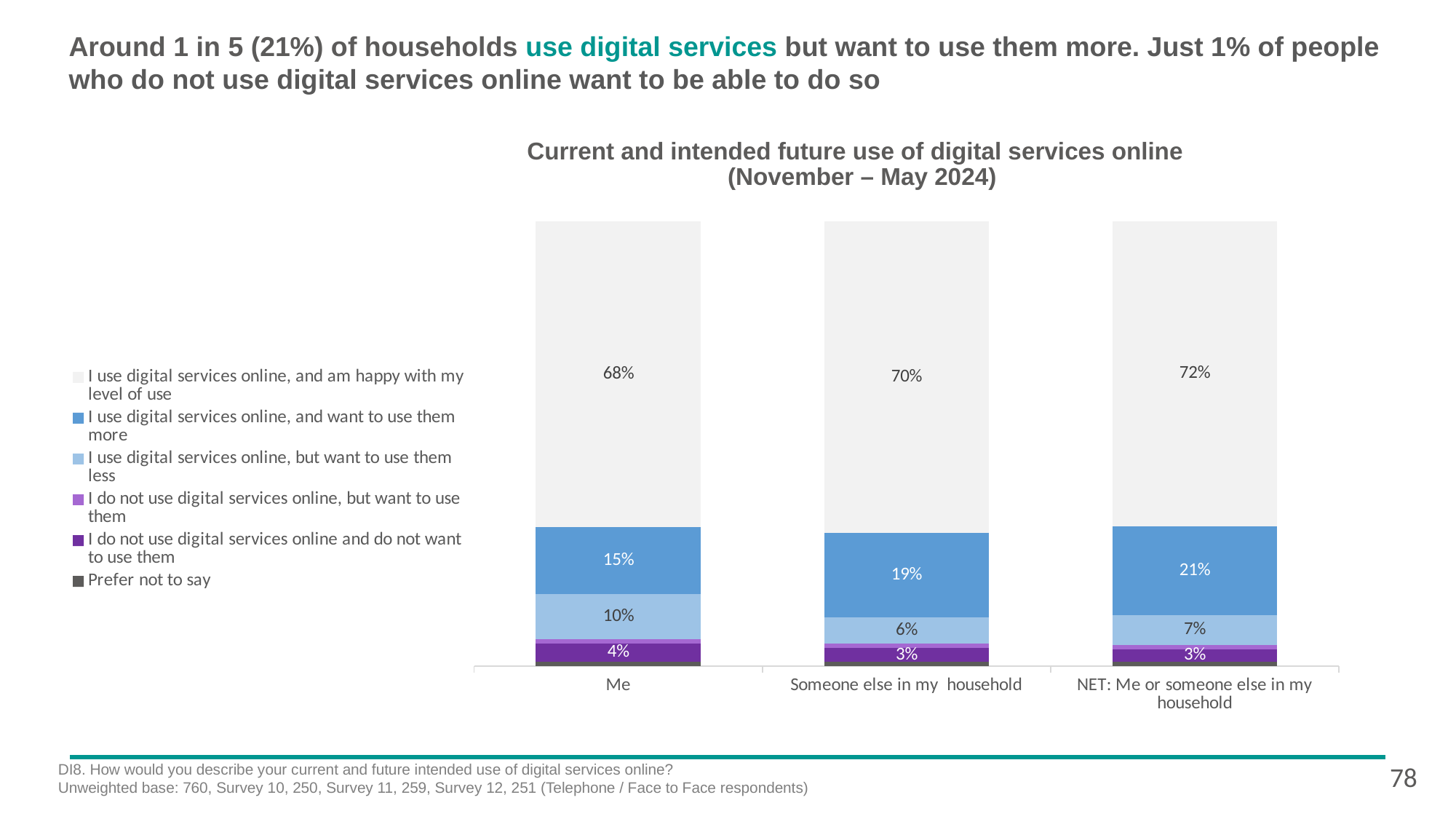
What is the value for 'I do not use digital services online and do not want to use them' in the 'Me' bar? 4% Which category has the highest value for 'I use digital services online, and am happy with my level of use'? NET: Me or someone else in my household What percentage of the 'Me' bar is 'I use digital services online, and am happy with my level of use'? 68% Which category has the lowest value for 'I use digital services online, and want to use them more'? Me What is the difference between the 'want to use them more' values for 'Someone else in my household' and 'Me'? 4% What kind of chart is shown on the slide? Stacked bar chart What is the title of the chart? Current and intended future use of digital services online (November – May 2024) How many categories are shown along the x axis of the chart? 3 How many series does the legend list? 6 Which is larger: the 'want to use them less' value for 'Me' or for 'NET: Me or someone else in my household'? Me What is the value for 'I use digital services online, but want to use them less' for 'Someone else in my household'? 6% What is the value for 'I use digital services online, and want to use them more' in the 'NET: Me or someone else in my household' bar? 21%